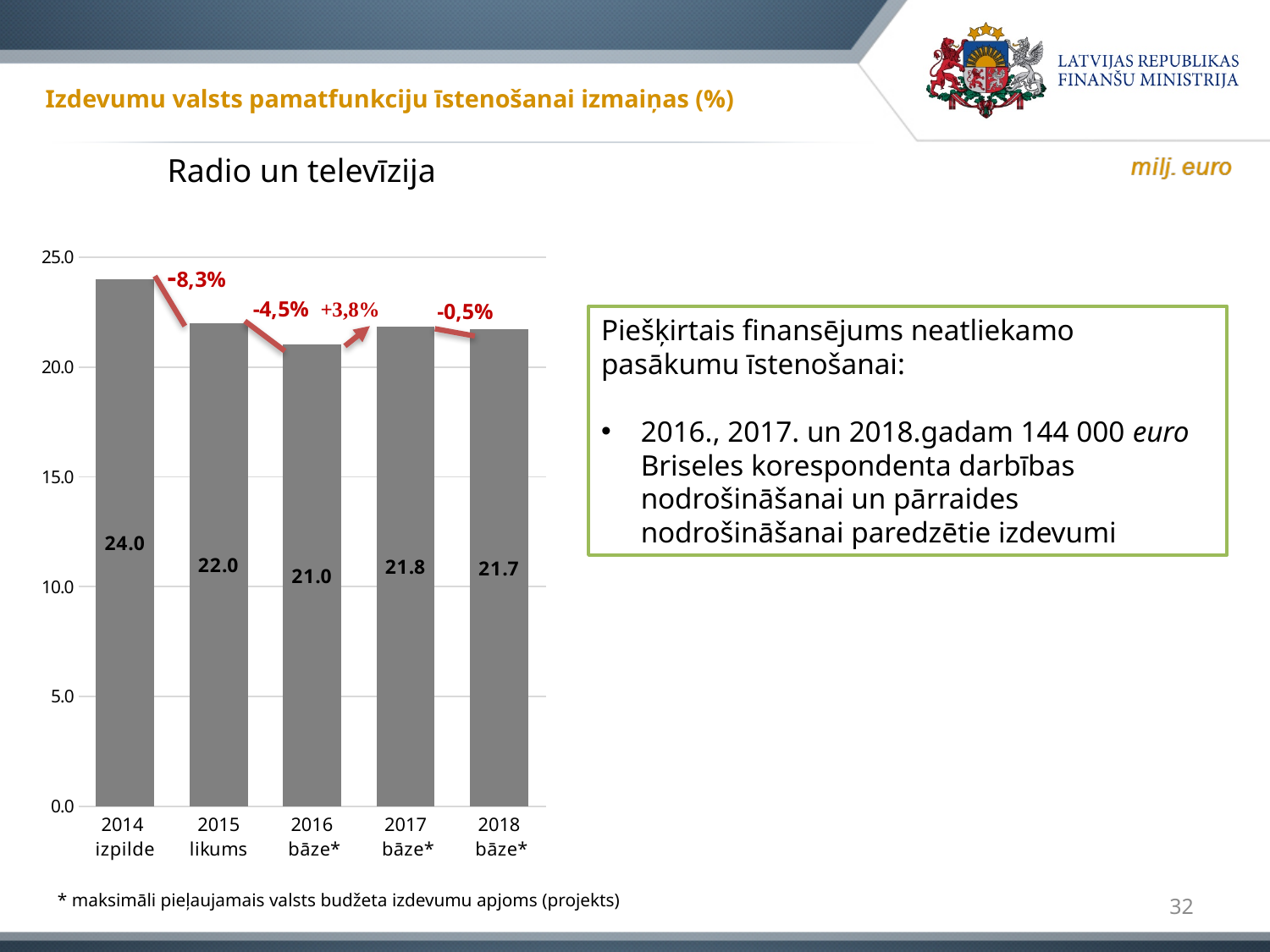
What is the value for 2018 bāze*? 21.7 What percentage change is shown between 2016 bāze* and 2017 bāze*? +3,8% What kind of chart is shown on the slide? bar chart Which category has the lowest value? 2016 bāze* Which category has the highest value? 2014 izpilde Which is larger, the value for 2017 bāze* or the value for 2016 bāze*? 2017 bāze* What is the difference between the values for 2014 izpilde and 2015 likums? 2.0 How many categories are shown on the x axis? 5 Is the value for 2015 likums greater or less than 20.0? greater What is the title of the chart? Radio un televīzija What is the value for 2016 bāze*? 21.0 What is the value for 2014 izpilde? 24.0